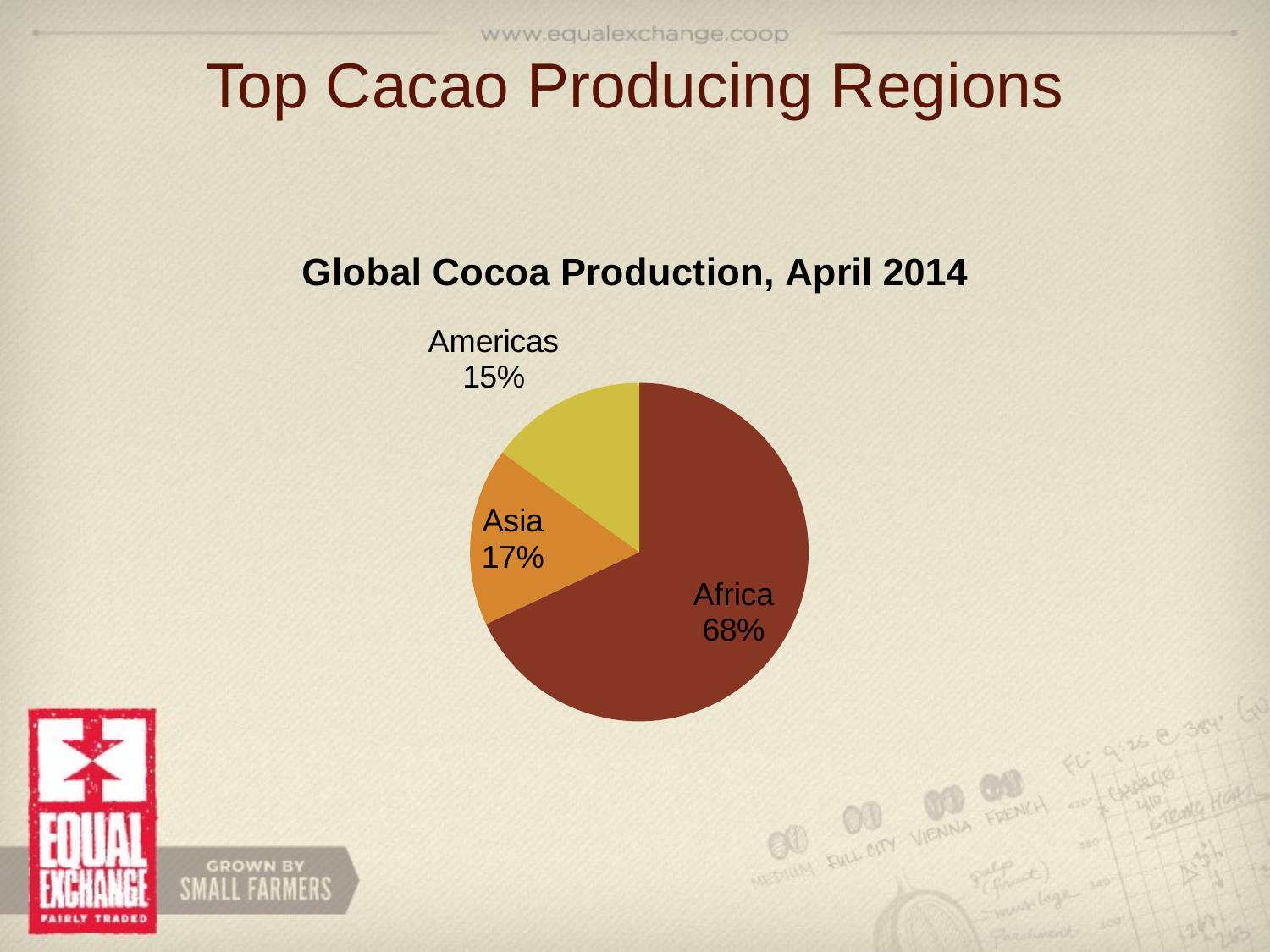
What is the difference in percentage points between Asia's share and the Americas' share? 2 What share of global cocoa production does Asia account for? 17% Which region has the smallest share of global cocoa production? Americas What is the title of the chart? Global Cocoa Production, April 2014 What share of global cocoa production does Africa account for? 68% What is the difference in percentage points between Africa's share and Asia's share? 51 Which has a larger share of global cocoa production, Asia or the Americas? Asia How many regions are shown in the pie chart? 3 What kind of chart is shown on the slide? pie chart What colour is the slice representing Africa? dark red-brown Which region has the largest share of global cocoa production? Africa What share of global cocoa production does the Americas account for? 15%